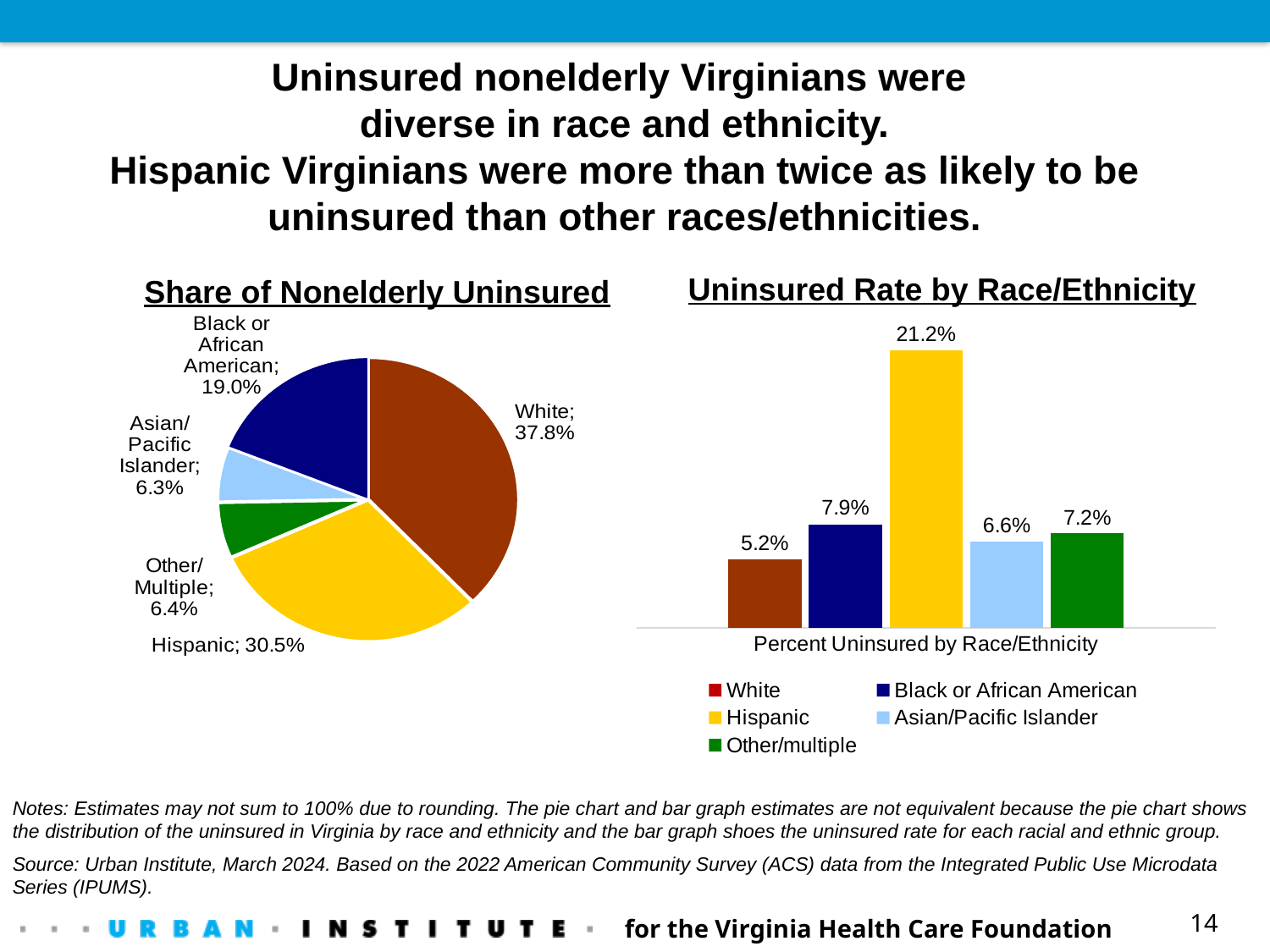
In the 'Share of Nonelderly Uninsured' pie chart, what share is Black or African American? 19.0% In the 'Uninsured Rate by Race/Ethnicity' chart, which group has the highest uninsured rate? Hispanic In the 'Uninsured Rate by Race/Ethnicity' chart, which group has the lowest uninsured rate? White In the 'Uninsured Rate by Race/Ethnicity' chart, what is the uninsured rate for Hispanic Virginians? 21.2% In the 'Share of Nonelderly Uninsured' pie chart, which group has the smallest share? Asian/Pacific Islander How many slices does the 'Share of Nonelderly Uninsured' pie chart have? 5 In the 'Uninsured Rate by Race/Ethnicity' chart, what is the uninsured rate for White Virginians? 5.2% In the 'Uninsured Rate by Race/Ethnicity' chart, which is larger: the uninsured rate for Black or African American or for Other/multiple? Black or African American How many series does the legend of the 'Uninsured Rate by Race/Ethnicity' chart list? 5 In the 'Uninsured Rate by Race/Ethnicity' chart, what is the difference between the Hispanic and White uninsured rates? 16.0% What kind of chart is 'Uninsured Rate by Race/Ethnicity'? Bar chart In the 'Share of Nonelderly Uninsured' pie chart, what share is White? 37.8%